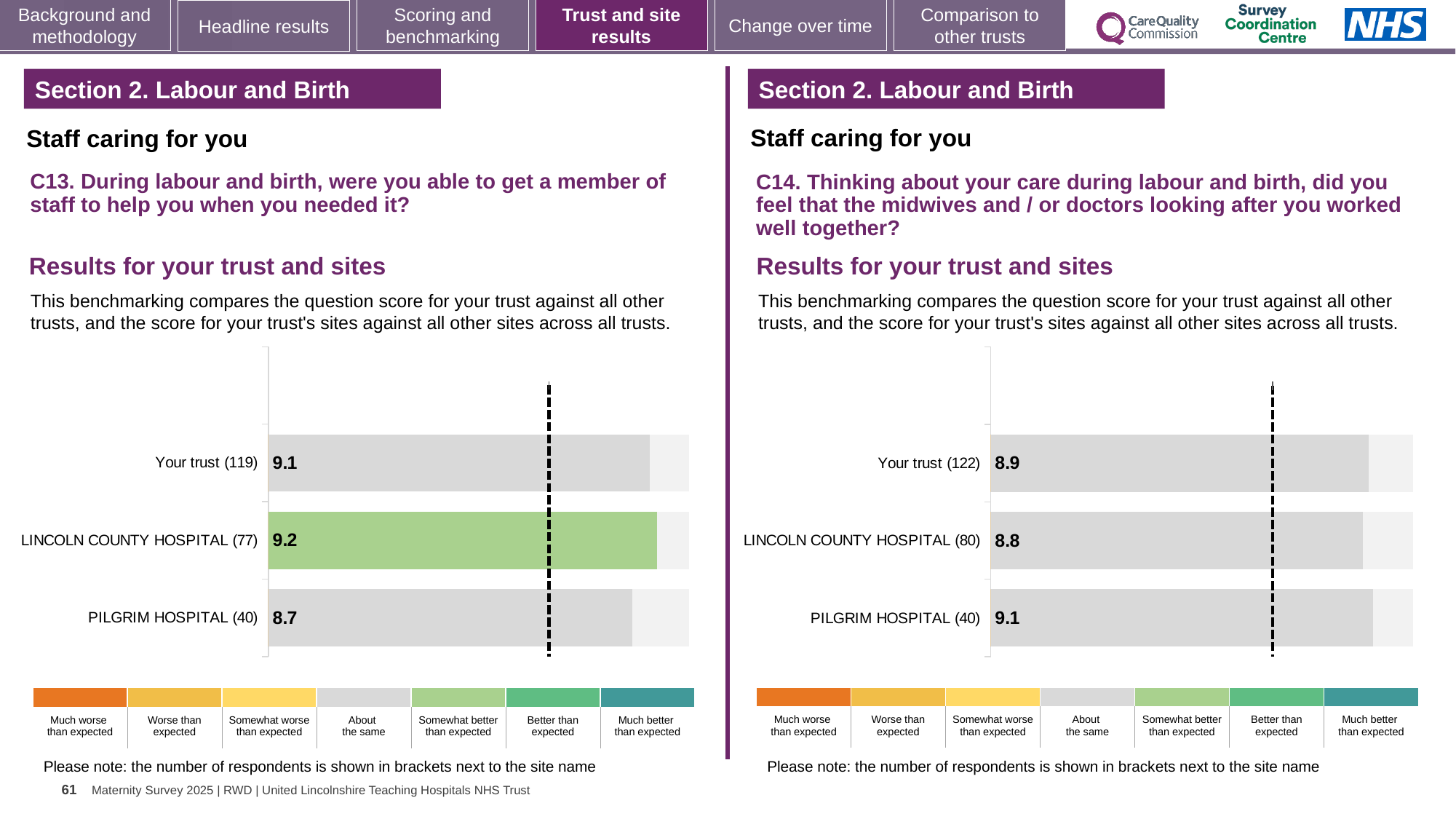
In the C13 chart on the left, what is the score for LINCOLN COUNTY HOSPITAL? 9.2 In the C13 chart on the left, what is the score for Your trust? 9.1 In the C14 chart on the right, what is the score for Your trust? 8.9 In the C14 chart on the right, what is the difference between the scores for PILGRIM HOSPITAL and LINCOLN COUNTY HOSPITAL? 0.3 In the C13 chart on the left, what is the score for PILGRIM HOSPITAL? 8.7 In the C13 chart on the left, how many respondents are shown in brackets for PILGRIM HOSPITAL? 40 In the C14 chart on the right, what is the score for LINCOLN COUNTY HOSPITAL? 8.8 In the C14 chart on the right, which site or trust has the highest score? PILGRIM HOSPITAL In the C13 chart on the left, what is the difference between the scores for LINCOLN COUNTY HOSPITAL and PILGRIM HOSPITAL? 0.5 How many bars are plotted in the C14 chart on the right? 3 In the C13 chart on the left, which site or trust has the lowest score? PILGRIM HOSPITAL What type of chart is used in the C13 chart on the left? Bar chart